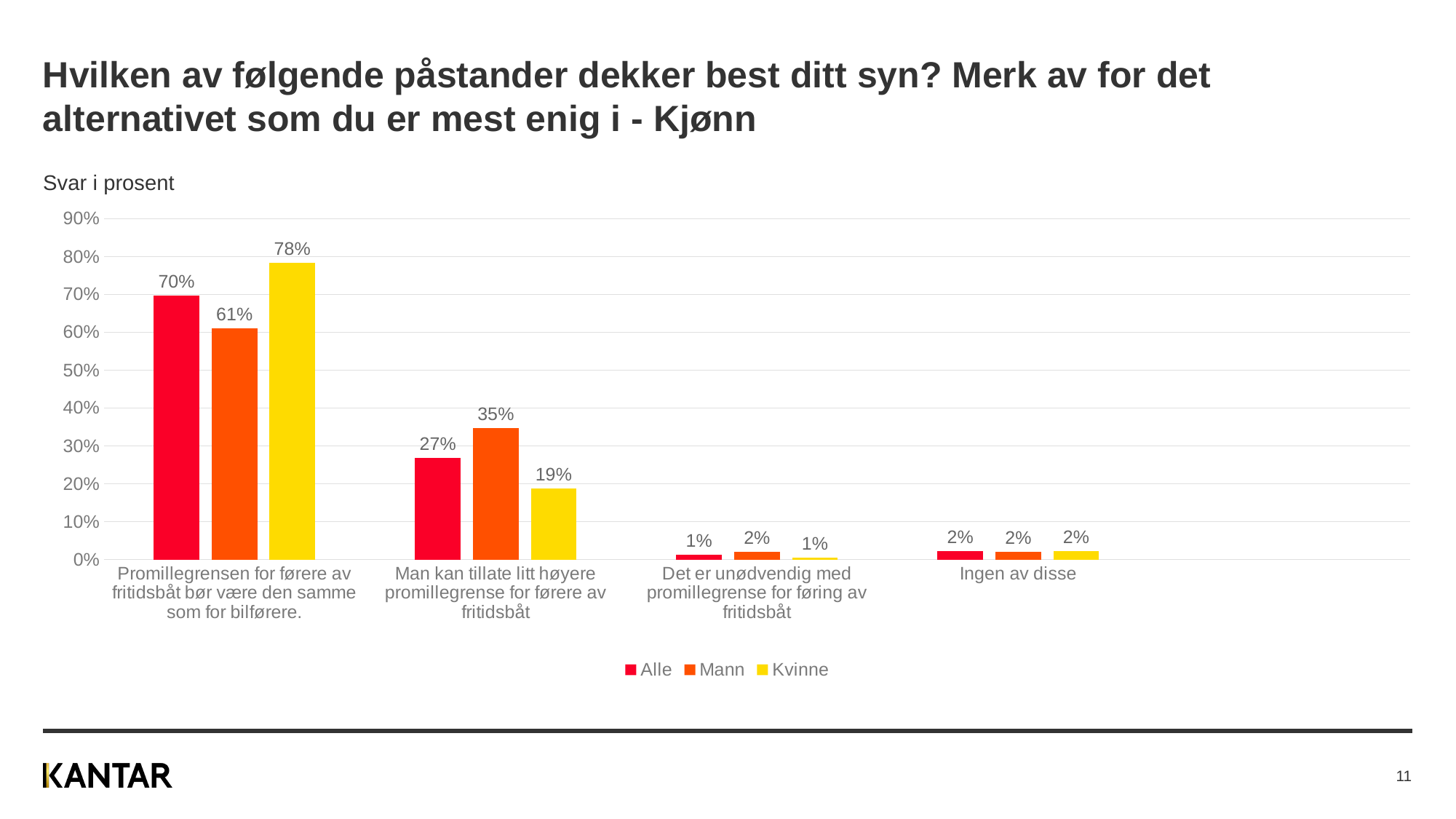
How many categories are shown on the x axis? 4 What is the difference between the Kvinne and Mann values for "Promillegrensen for førere av fritidsbåt bør være den samme som for bilførere."? 17% Which category has the lowest value for the Kvinne series? Det er unødvendig med promillegrense for føring av fritidsbåt For "Man kan tillate litt høyere promillegrense for førere av fritidsbåt", which is larger: Mann or Kvinne? Mann What is the value for Kvinne for "Promillegrensen for førere av fritidsbåt bør være den samme som for bilførere."? 78% What is the value for Mann for "Man kan tillate litt høyere promillegrense for førere av fritidsbåt"? 35% Which category has the highest value for the Alle series? Promillegrensen for førere av fritidsbåt bør være den samme som for bilførere. What is the value for Alle for "Ingen av disse"? 2% What kind of chart is shown on the slide? Bar chart Is the value for Alle for "Promillegrensen for førere av fritidsbåt bør være den samme som for bilførere." greater or less than 60%? greater How many series does the legend list? 3 Which series is shown in yellow? Kvinne